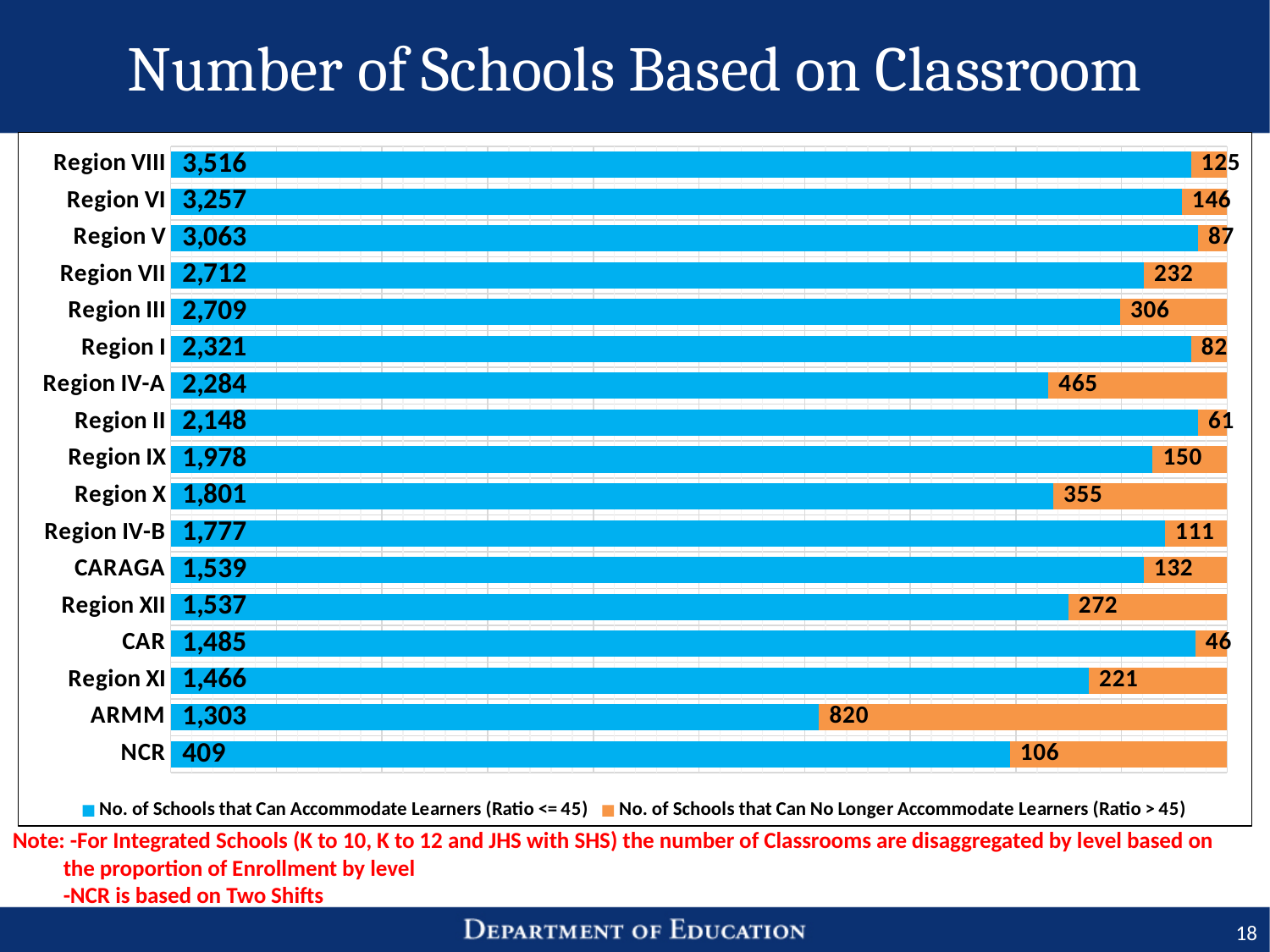
Which region has the lowest number of schools that can no longer accommodate learners (Ratio > 45)? CAR How many regions are shown in the chart? 17 What is the difference between Region VIII and Region VI in the number of schools that can accommodate learners (Ratio <= 45)? 259 Which region has the highest number of schools that can accommodate learners (Ratio <= 45)? Region VIII What is the number of schools that can accommodate learners (Ratio <= 45) in NCR? 409 What type of chart is shown on the slide? Bar chart What is the total number of schools shown for ARMM across both series? 2,123 How many series does the legend list? 2 Which region has the highest number of schools that can no longer accommodate learners (Ratio > 45)? ARMM Which has more schools that can no longer accommodate learners (Ratio > 45): Region X or Region IX? Region X How many schools in ARMM can no longer accommodate learners (Ratio > 45)? 820 How many schools in Region VIII can accommodate learners (Ratio <= 45)? 3,516